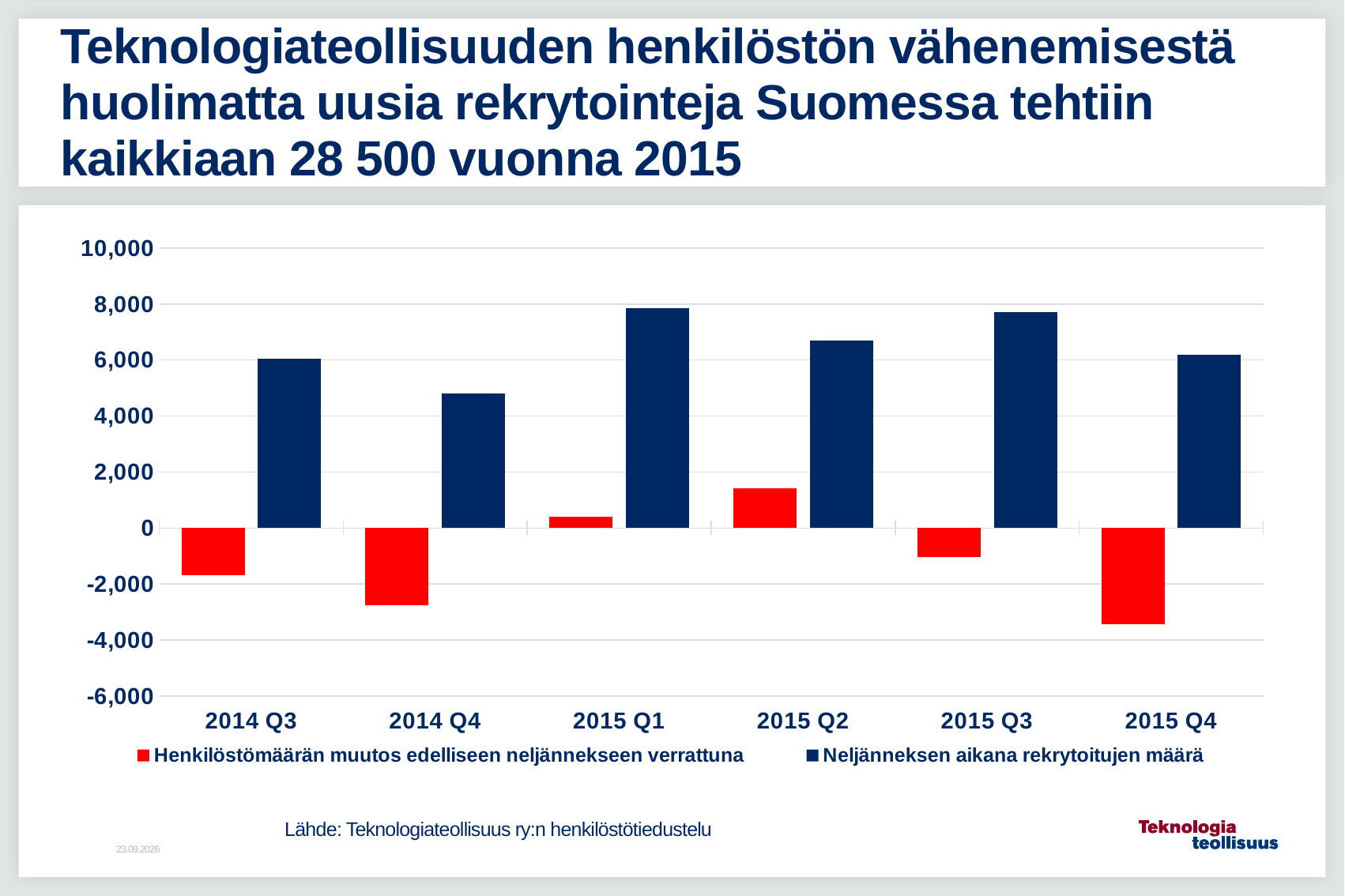
Which quarter has the highest value for 'Henkilöstömäärän muutos edelliseen neljännekseen verrattuna'? 2015 Q2 Is the value for 'Neljänneksen aikana rekrytoitujen määrä' in 2014 Q4 greater or less than 6,000? less Which quarter has the lowest value for 'Neljänneksen aikana rekrytoitujen määrä'? 2014 Q4 Which colour represents 'Neljänneksen aikana rekrytoitujen määrä' in the chart? dark blue Which quarter has the lowest value for 'Henkilöstömäärän muutos edelliseen neljännekseen verrattuna'? 2015 Q4 Which is larger for 'Neljänneksen aikana rekrytoitujen määrä': 2015 Q2 or 2015 Q3? 2015 Q3 How many series does the legend list? 2 What kind of chart is shown on the slide? bar chart Is the value for 'Henkilöstömäärän muutos edelliseen neljännekseen verrattuna' in 2015 Q2 greater or less than 2,000? less Is the value for 'Henkilöstömäärän muutos edelliseen neljännekseen verrattuna' in 2015 Q4 greater or less than -2,000? less How many quarters are shown on the x axis? 6